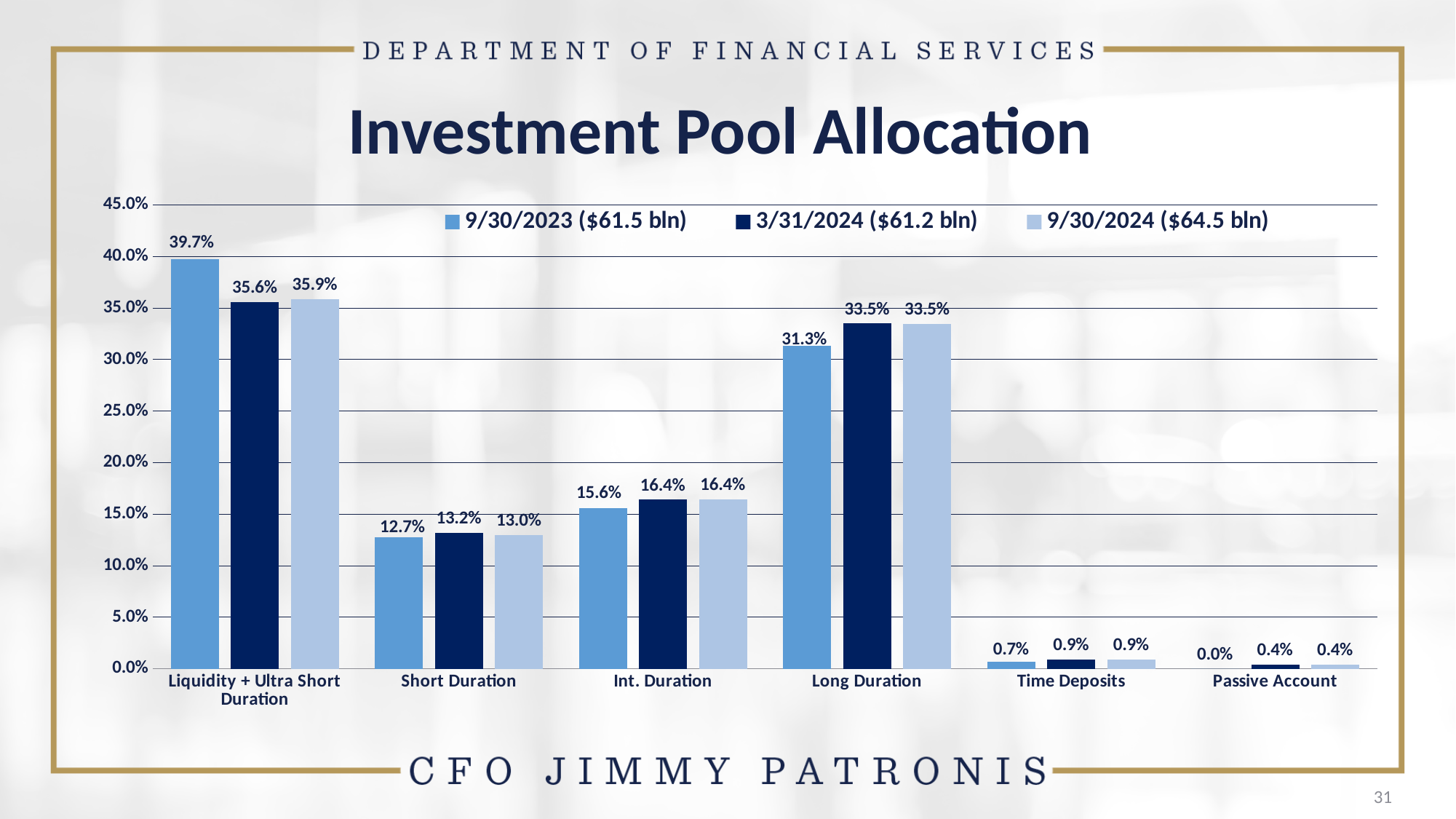
Which is larger for Int. Duration: the 9/30/2023 value or the 3/31/2024 value? 3/31/2024 What is the value for Long Duration in the 3/31/2024 ($61.2 bln) series? 33.5% What is the value for Liquidity + Ultra Short Duration in the 9/30/2023 ($61.5 bln) series? 39.7% What is the difference between the 9/30/2023 and 3/31/2024 values for Liquidity + Ultra Short Duration? 4.1% How many series does the legend list? 3 What is the value for Passive Account in the 9/30/2024 ($64.5 bln) series? 0.4% Is the 9/30/2023 value for Long Duration greater or less than 30.0%? greater Which category has the lowest value in the 9/30/2023 ($61.5 bln) series? Passive Account What kind of chart is shown on the slide? Bar chart How many categories are shown on the x axis? 6 What is the title of the chart? Investment Pool Allocation Which category has the highest value in the 9/30/2024 ($64.5 bln) series? Liquidity + Ultra Short Duration